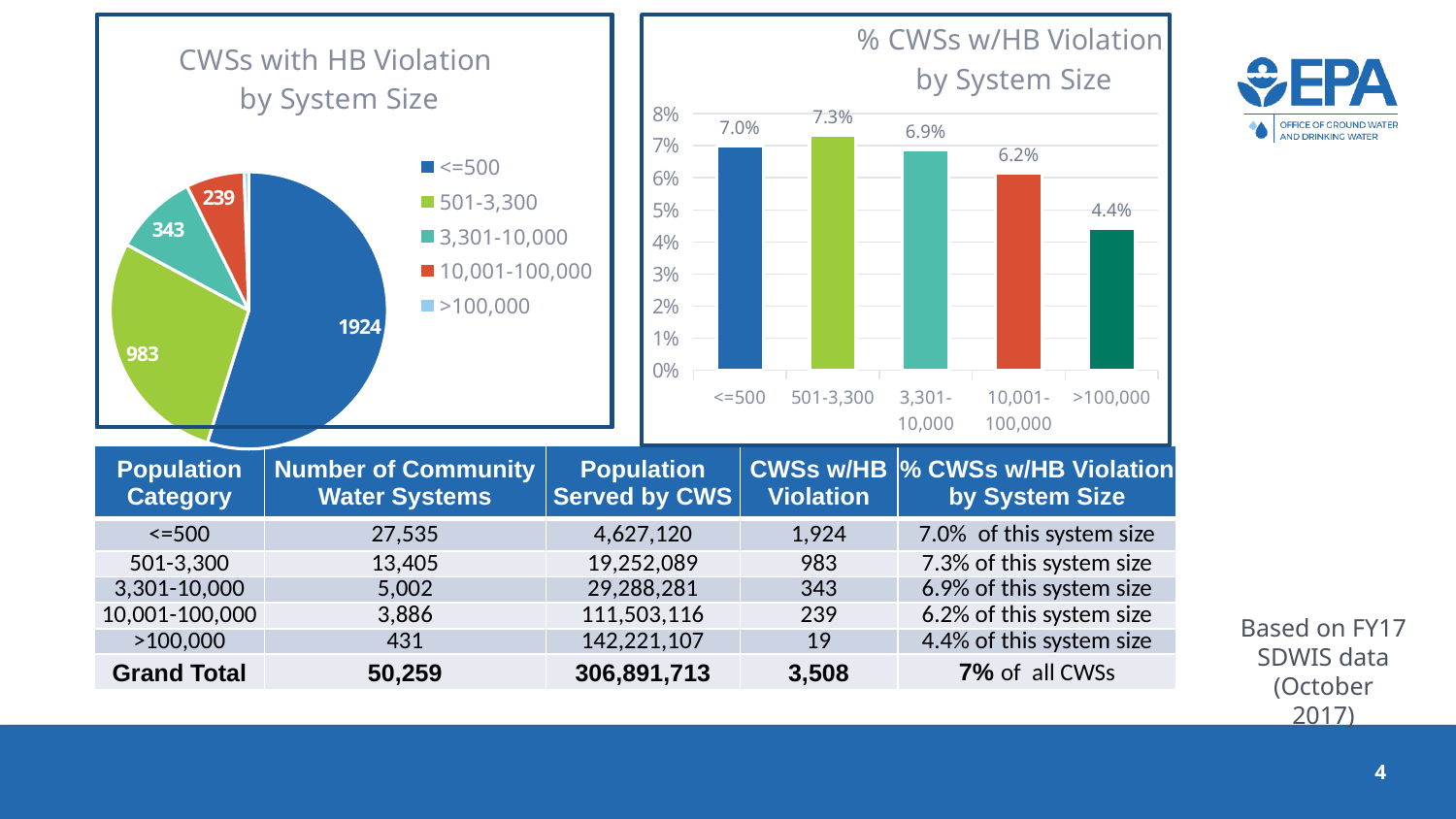
In the bar chart '% CWSs w/HB Violation by System Size', what is the value for 501-3,300? 7.3% In the pie chart 'CWSs with HB Violation by System Size', what is the value for the <=500 category? 1924 In the pie chart 'CWSs with HB Violation by System Size', how many categories does the legend list? 5 In the bar chart '% CWSs w/HB Violation by System Size', what is the value for >100,000? 4.4% In the pie chart 'CWSs with HB Violation by System Size', what is the value for the 3,301-10,000 category? 343 In the bar chart '% CWSs w/HB Violation by System Size', which category has the lowest value? >100,000 In the pie chart 'CWSs with HB Violation by System Size', what is the difference between the <=500 and 501-3,300 values? 941 In the pie chart 'CWSs with HB Violation by System Size', which category has the largest slice? <=500 What kind of chart is the left chart, 'CWSs with HB Violation by System Size'? Pie chart What kind of chart is the right chart, '% CWSs w/HB Violation by System Size'? Bar chart In the bar chart '% CWSs w/HB Violation by System Size', which is larger: the value for <=500 or the value for 10,001-100,000? <=500 In the bar chart '% CWSs w/HB Violation by System Size', what is the difference between the highest and lowest values? 2.9%